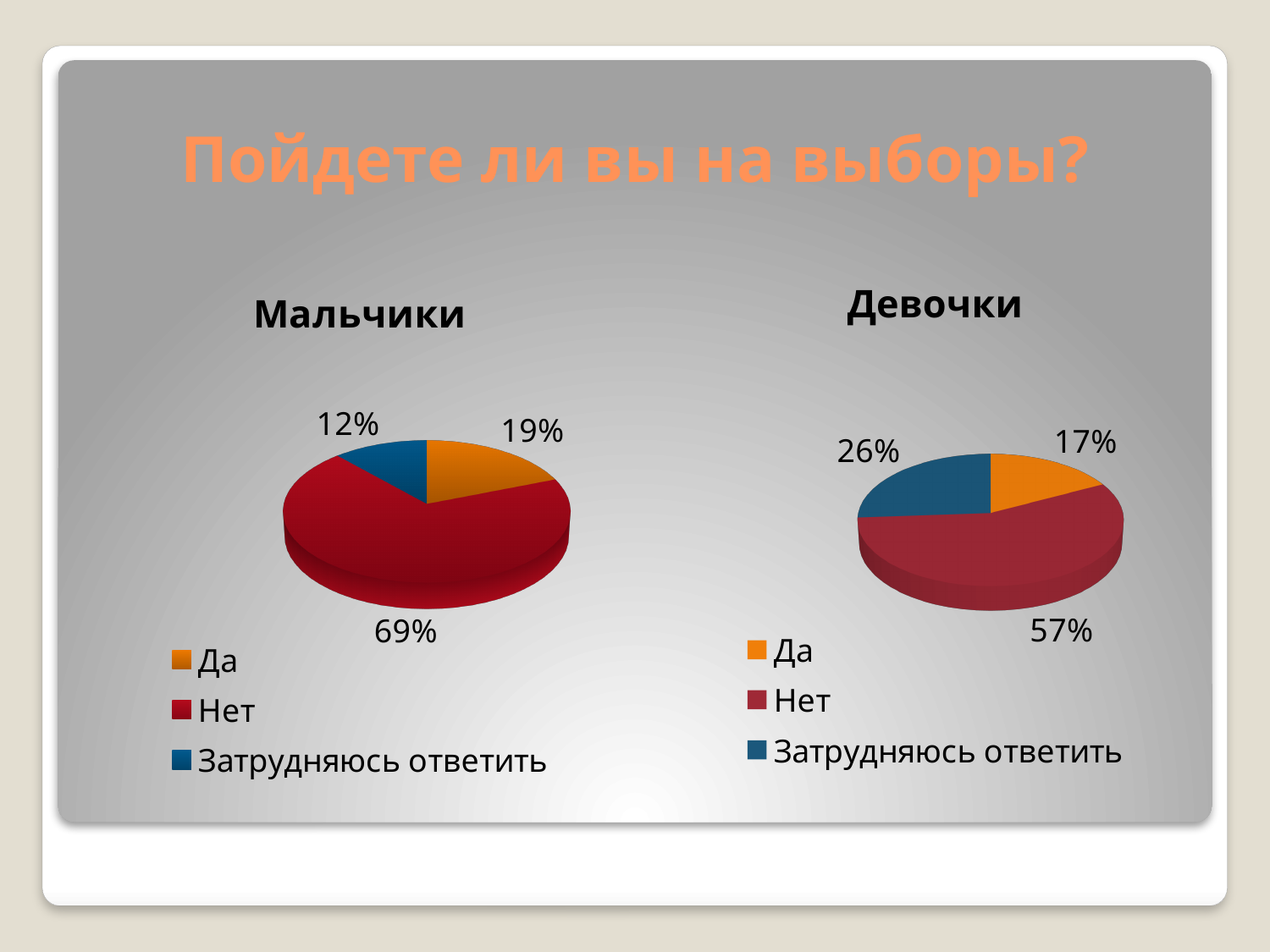
In the 'Девочки' chart, what percentage answered 'Да'? 17% In the 'Девочки' chart, which answer has the smallest share? Да In the 'Мальчики' chart, what is the difference between the 'Да' and 'Затрудняюсь ответить' shares? 7% In the 'Девочки' chart, what percentage answered 'Затрудняюсь ответить'? 26% In the 'Мальчики' chart, what percentage answered 'Нет'? 69% What is the title of the slide? Пойдете ли вы на выборы? What type of chart is the 'Девочки' chart? Pie chart In the 'Мальчики' chart, which answer has the largest share? Нет In the 'Мальчики' chart, which answer has the smallest share? Затрудняюсь ответить What is the difference between the 'Нет' share in the 'Мальчики' chart and the 'Нет' share in the 'Девочки' chart? 12% How many slices does the 'Мальчики' pie chart have? 3 Which is larger: the 'Затрудняюсь ответить' share in the 'Мальчики' chart or in the 'Девочки' chart? Девочки